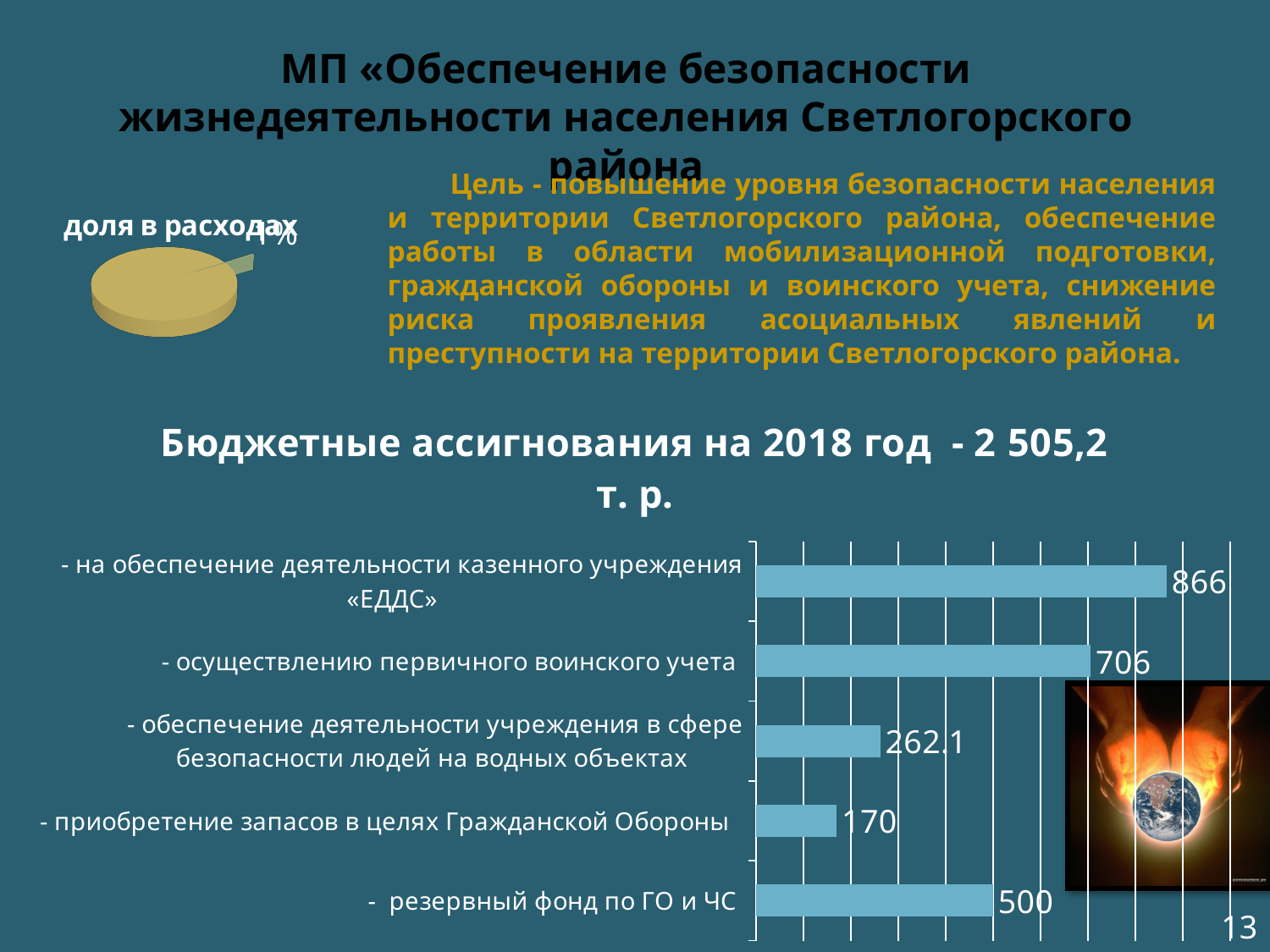
In the bar chart, what is the difference between the values for «резервный фонд по ГО и ЧС» and «приобретение запасов в целях Гражданской Обороны»? 330 In the bar chart, what is the difference between the values for «ЕДДС» and «осуществлению первичного воинского учета»? 160 In the bar chart, what is the value for «на обеспечение деятельности казенного учреждения «ЕДДС»»? 866 In the bar chart, which is larger: the value for «осуществлению первичного воинского учета» or for «резервный фонд по ГО и ЧС»? осуществлению первичного воинского учета How many categories does the bar chart show? 5 What kind of chart is the chart titled «доля в расходах» in the upper left of the slide? pie chart In the bar chart, what is the value for «осуществлению первичного воинского учета»? 706 In the bar chart, which category has the lowest value? приобретение запасов в целях Гражданской Обороны In the bar chart, what is the value for «резервный фонд по ГО и ЧС»? 500 In the bar chart, what is the value for «обеспечение деятельности учреждения в сфере безопасности людей на водных объектах»? 262.1 In the bar chart, what is the value for «приобретение запасов в целях Гражданской Обороны»? 170 In the bar chart, which category has the highest value? на обеспечение деятельности казенного учреждения «ЕДДС»